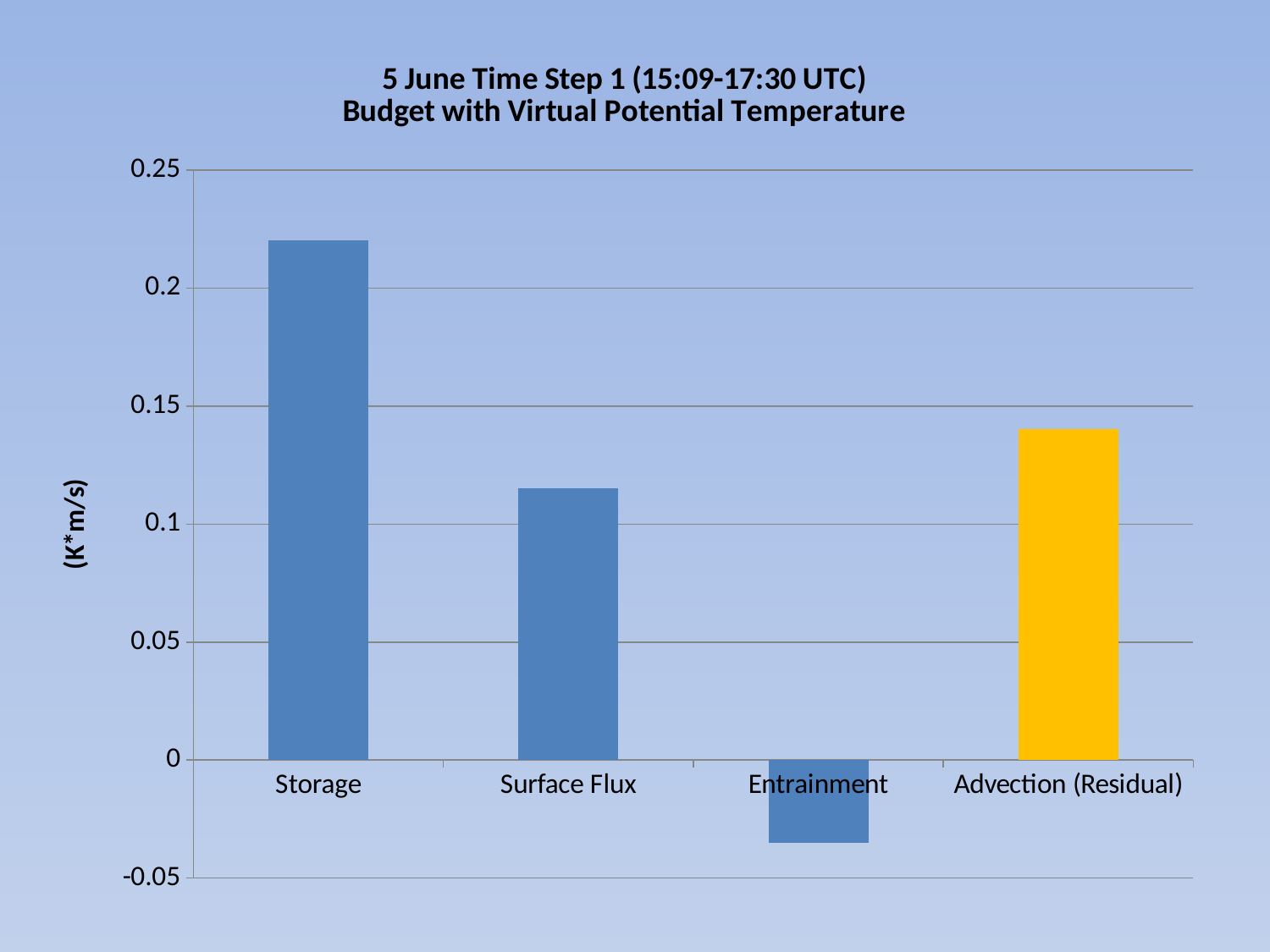
Is the value for Surface Flux greater or less than 0.15? less Is the value for Storage greater or less than 0.2? greater Is the value for Advection (Residual) greater or less than 0.1? greater What is the label on the vertical axis of the chart? (K*m/s) What kind of chart is shown on the slide? bar chart Which is larger, the value for Storage or the value for Surface Flux? Storage Which category's bar is coloured yellow rather than blue? Advection (Residual) Which category has the lowest value? Entrainment Which is larger, the value for Advection (Residual) or the value for Surface Flux? Advection (Residual) Which category has the highest value? Storage How many categories are plotted on the chart? 4